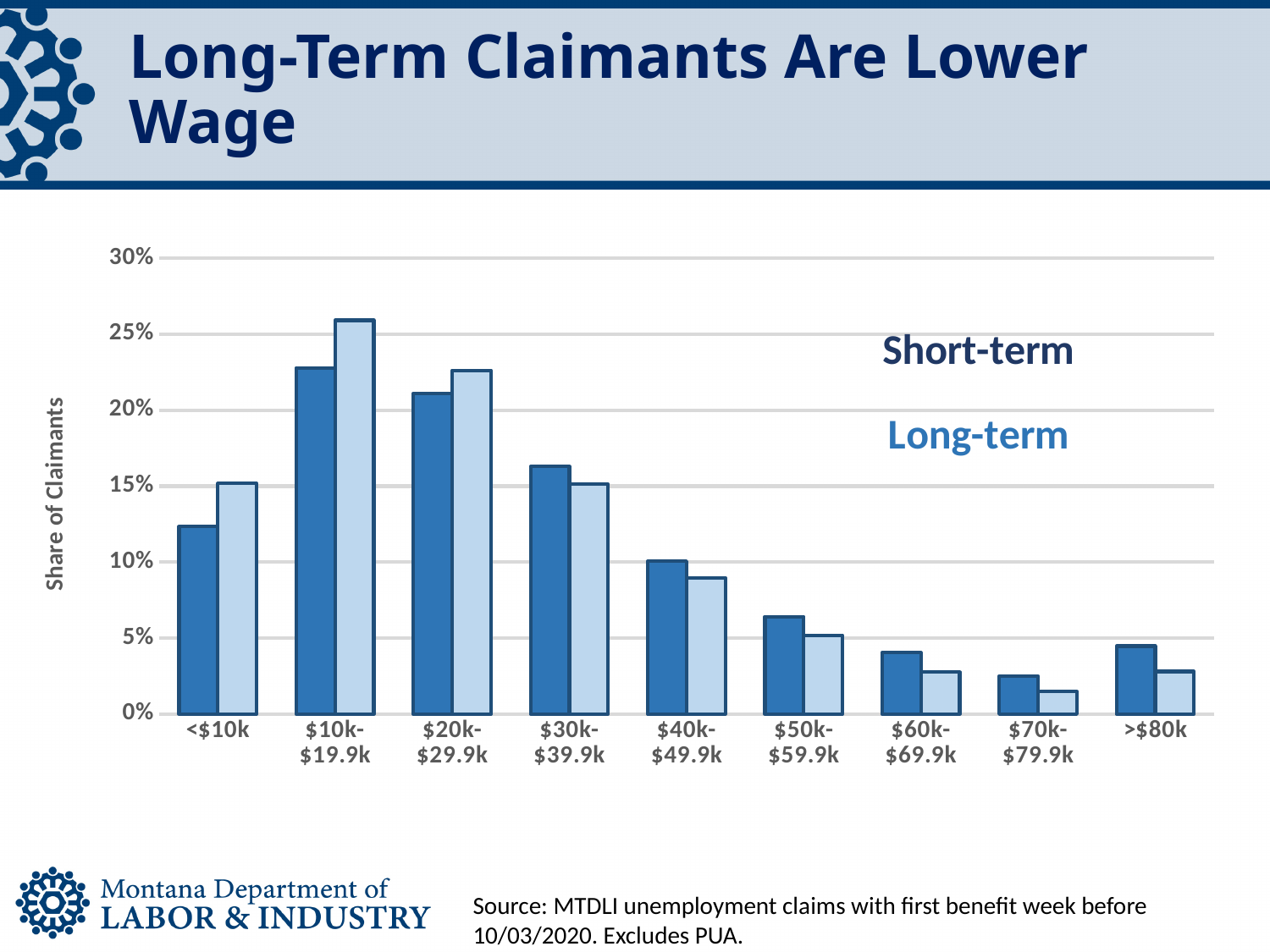
What kind of chart is shown on the slide? bar chart From $10k-$19.9k to $70k-$79.9k, does the Short-term share rise or fall? fall Is the Long-term share for $10k-$19.9k greater or less than 20%? greater How many series does the chart show? 2 For the $40k-$49.9k category, which series has the larger share: Short-term or Long-term? Short-term What is the label on the y axis? Share of Claimants For the <$10k category, which series has the larger share: Short-term or Long-term? Long-term Which wage category has the highest share of Long-term claimants? $10k-$19.9k Which wage category has the lowest share of Short-term claimants? $70k-$79.9k Is the Short-term share for <$10k greater or less than 15%? less How many wage categories are shown on the x axis? 9 Which wage category has the lowest share of Long-term claimants? $70k-$79.9k